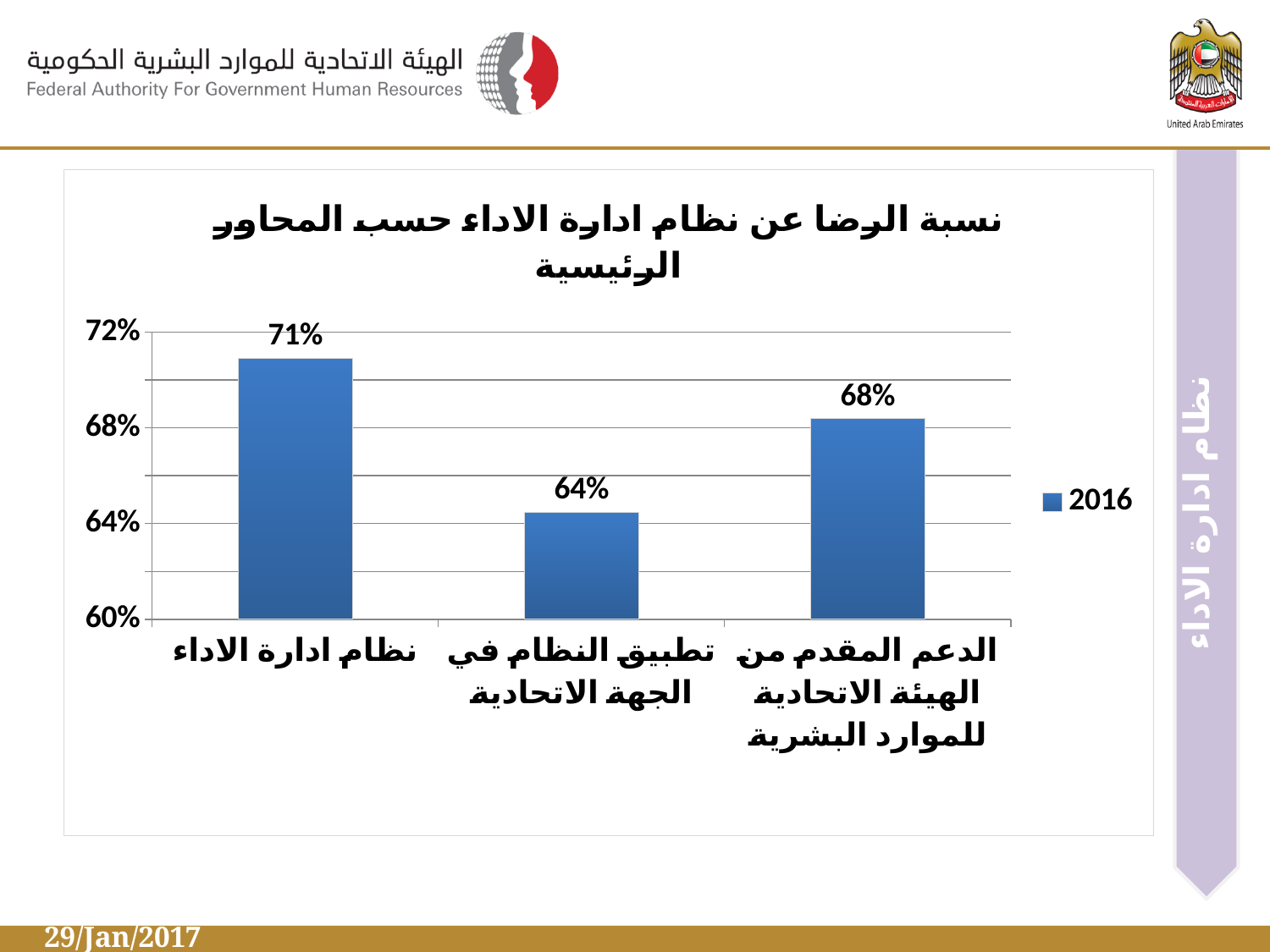
What is the value for "نظام ادارة الاداء"? 71% How many categories are shown on the chart? 3 What kind of chart is shown on the slide? bar chart Is the value for "تطبيق النظام في الجهة الاتحادية" greater or less than 68%? less What is the value for "تطبيق النظام في الجهة الاتحادية"? 64% What is the value for "الدعم المقدم من الهيئة الاتحادية للموارد البشرية"? 68% What is the difference between the values for "نظام ادارة الاداء" and "تطبيق النظام في الجهة الاتحادية"? 7% Which category has the highest value? نظام ادارة الاداء Which is larger: the value for "نظام ادارة الاداء" or the value for "الدعم المقدم من الهيئة الاتحادية للموارد البشرية"? نظام ادارة الاداء What is the difference between the values for "الدعم المقدم من الهيئة الاتحادية للموارد البشرية" and "تطبيق النظام في الجهة الاتحادية"? 4% Which category has the lowest value? تطبيق النظام في الجهة الاتحادية How many series does the legend list? 1